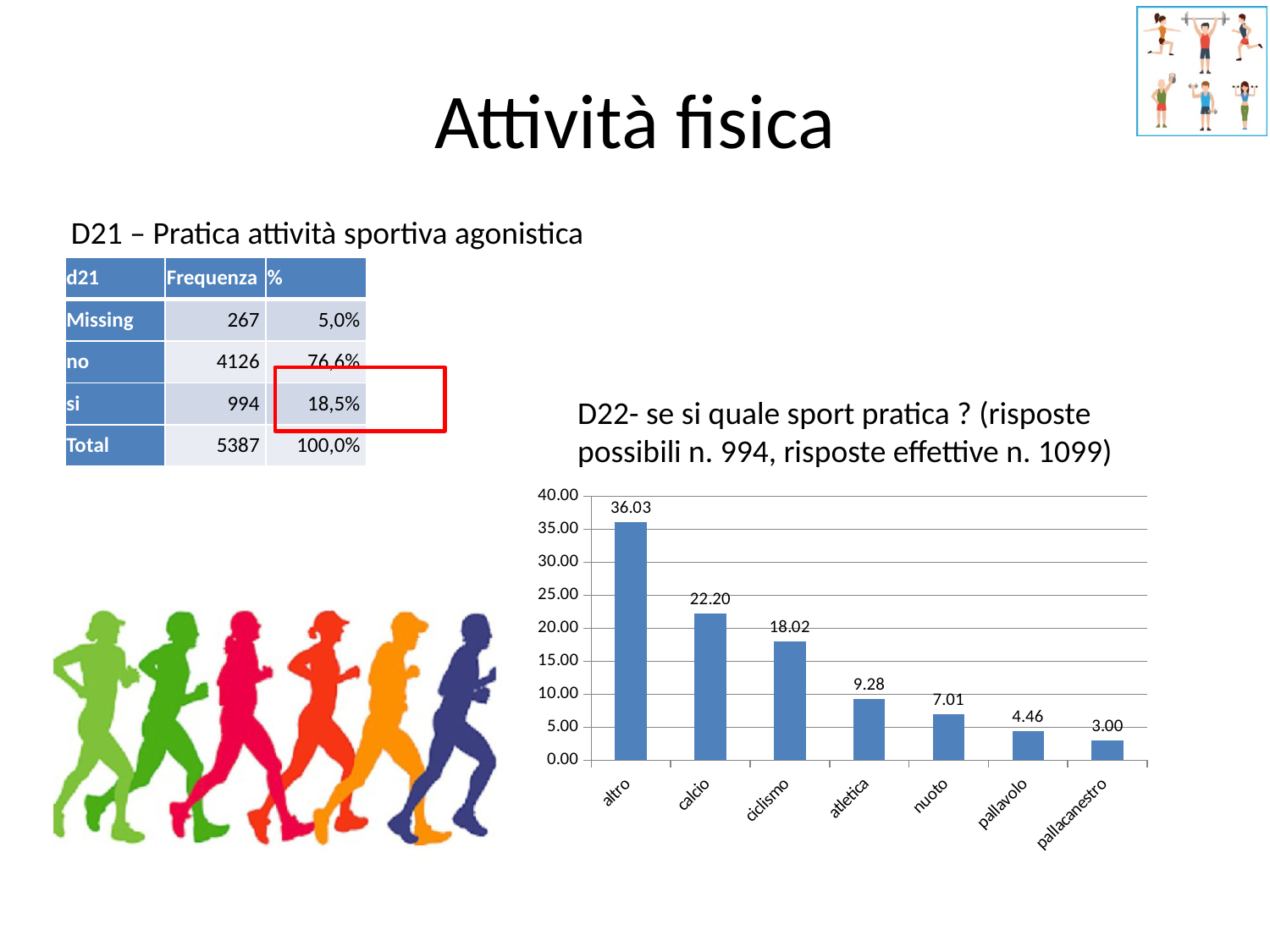
What is the difference between the values for altro and calcio in the bar chart? 13.83 What is the value for pallacanestro in the bar chart? 3.00 Is the value for ciclismo in the bar chart greater or less than 15.00? greater Do the values in the bar chart rise or fall from left to right along the x axis? fall Which category has the lowest value in the bar chart? pallacanestro Which has a larger value in the bar chart, atletica or pallavolo? atletica What is the difference between the values for ciclismo and atletica in the bar chart? 8.74 What is the value for calcio in the bar chart? 22.20 What kind of chart is used to show the sports practised? bar chart How many categories are shown in the bar chart? 7 Which category has the highest value in the bar chart? altro What is the value for nuoto in the bar chart? 7.01